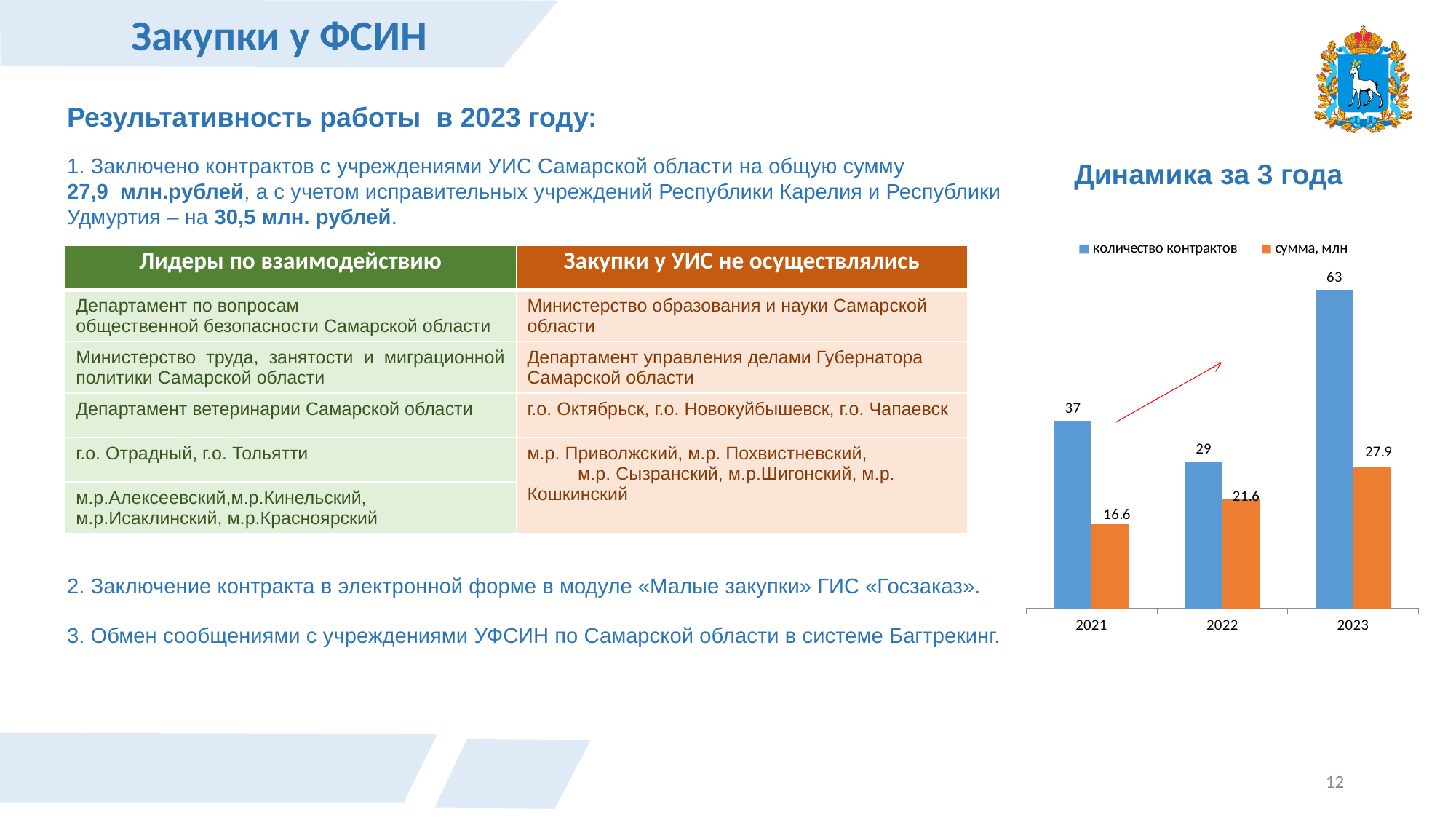
How many years are shown on the x axis of the "Динамика за 3 года" chart? 3 What type of chart is shown under the title "Динамика за 3 года"? bar chart What is the value of "количество контрактов" for 2023? 63 Which is larger: "количество контрактов" in 2021 or in 2022? 2021 Does "сумма, млн" rise or fall from 2021 to 2023? rise In which year is "сумма, млн" the lowest? 2021 What is the value of "сумма, млн" for 2022? 21.6 What is the value of "количество контрактов" for 2021? 37 In which year is "количество контрактов" the highest? 2023 What is the difference in "количество контрактов" between 2023 and 2022? 34 How many series does the legend of the "Динамика за 3 года" chart list? 2 What is the value of "сумма, млн" for 2023? 27.9